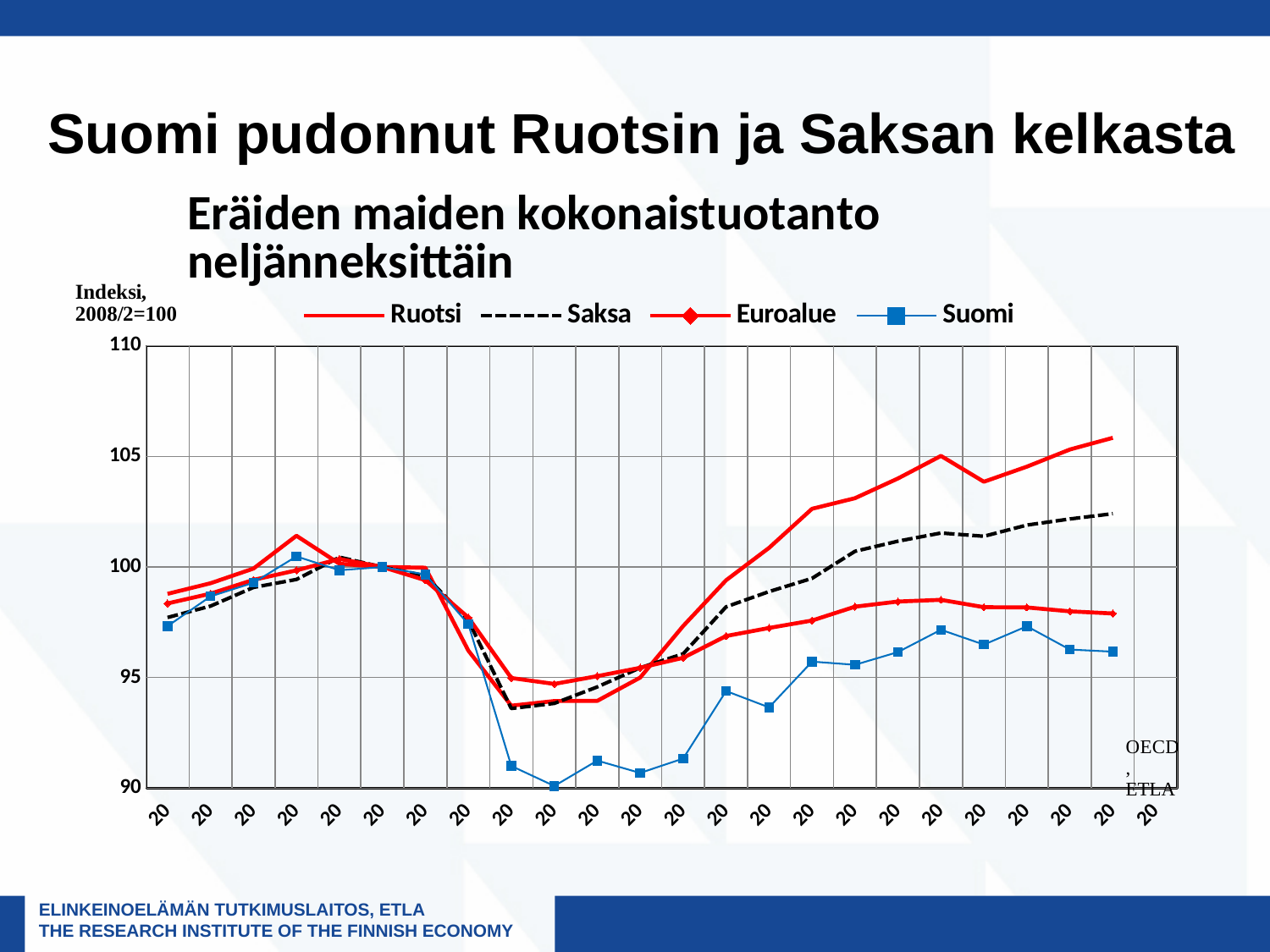
How many series does the legend list? 4 Is the final value for Saksa greater or less than 100? greater What is the title of the chart? Eräiden maiden kokonaistuotanto neljänneksittäin At the right end of the chart, which is higher, Ruotsi or Saksa? Ruotsi Which series has the lowest value at the right end of the chart? Suomi Which series are listed in the chart legend? Ruotsi, Saksa, Euroalue, Suomi Is the lowest value for Suomi greater or less than 95? less What kind of chart is shown on the slide? line chart Is the final value for Ruotsi greater or less than 105? greater At the right end of the chart, which is higher, Suomi or Euroalue? Euroalue Which series has the highest value at the right end of the chart? Ruotsi Does the Ruotsi series rise or fall from its lowest point to the right end of the chart? rise